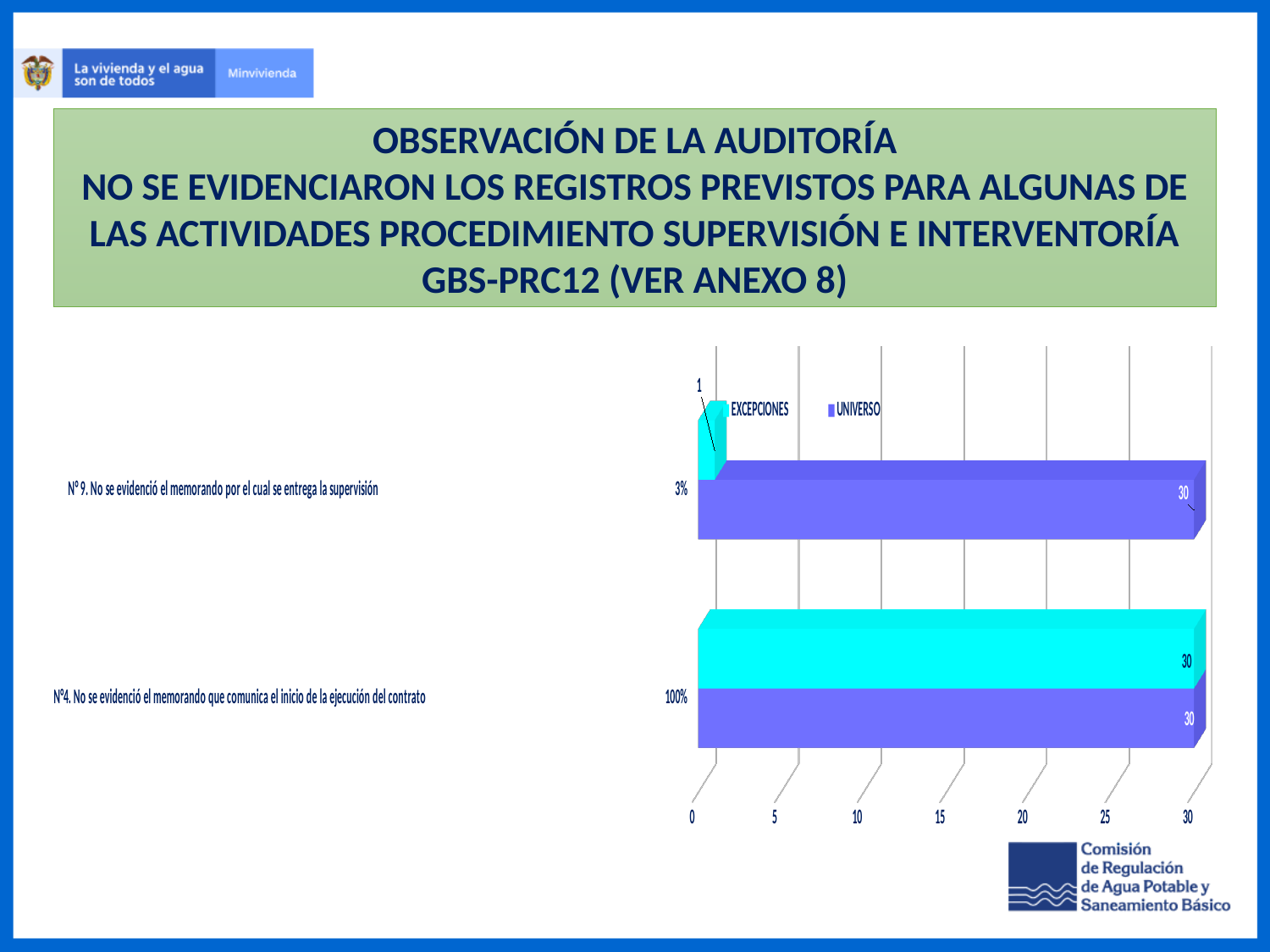
What is the difference between the UNIVERSO and EXCEPCIONES values for the category 'N° 9. No se evidenció el memorando por el cual se entrega la supervisión'? 29 For the category 'N° 9. No se evidenció el memorando por el cual se entrega la supervisión', which series has the larger value, EXCEPCIONES or UNIVERSO? UNIVERSO What percentage label is shown next to the category 'N°4. No se evidenció el memorando que comunica el inicio de la ejecución del contrato'? 100% What percentage label is shown next to the category 'N° 9. No se evidenció el memorando por el cual se entrega la supervisión'? 3% How many series does the chart legend list? 2 What is the EXCEPCIONES value for the category 'N°4. No se evidenció el memorando que comunica el inicio de la ejecución del contrato'? 30 How many categories are plotted in the chart? 2 What kind of chart is shown on the slide? bar chart Which category has the lower EXCEPCIONES value? N° 9. No se evidenció el memorando por el cual se entrega la supervisión What is the EXCEPCIONES value for the category 'N° 9. No se evidenció el memorando por el cual se entrega la supervisión'? 1 What is the UNIVERSO value for the category 'N°4. No se evidenció el memorando que comunica el inicio de la ejecución del contrato'? 30 What is the UNIVERSO value for the category 'N° 9. No se evidenció el memorando por el cual se entrega la supervisión'? 30